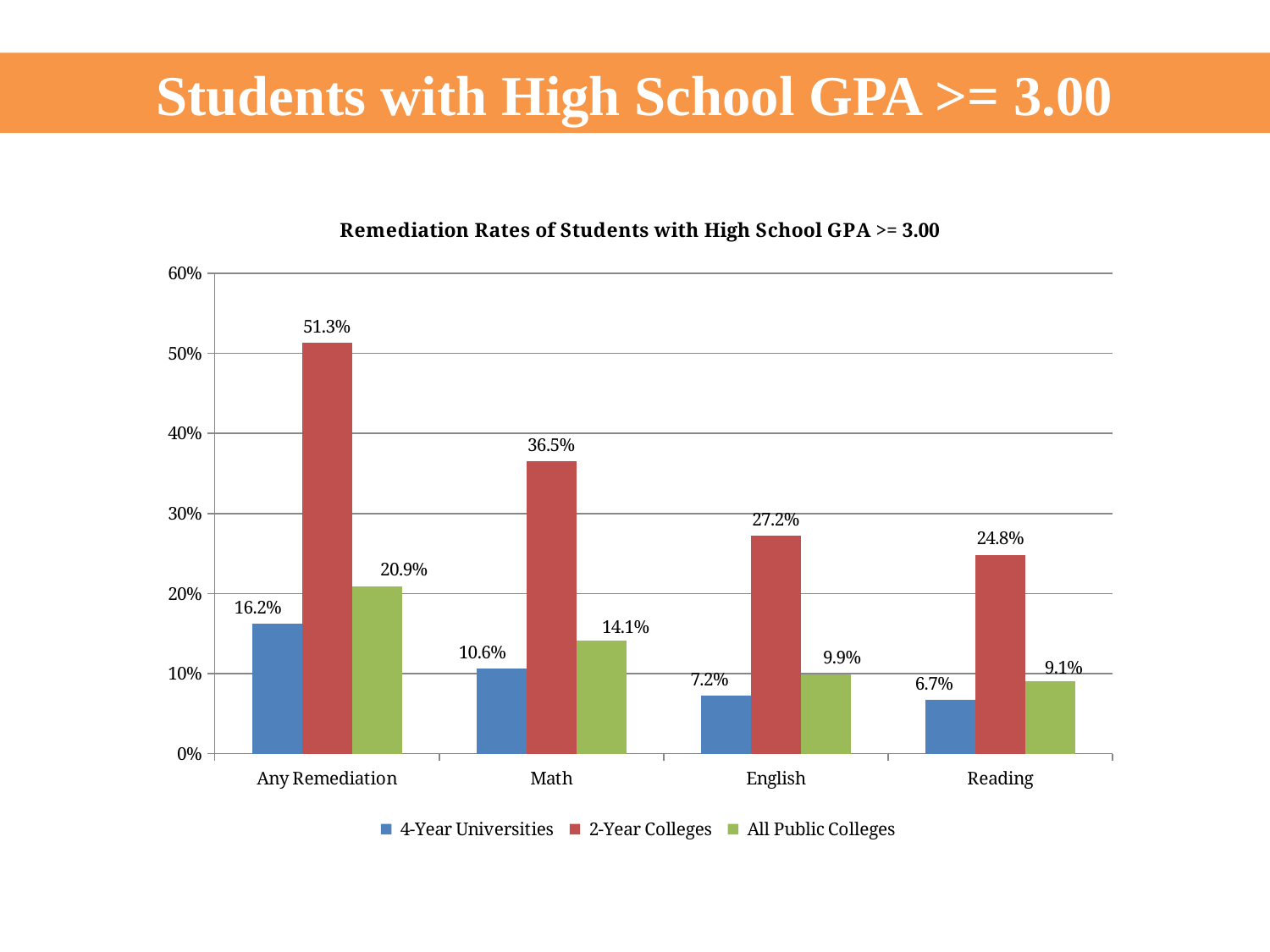
What is the remediation rate for 4-Year Universities in Math? 10.6% What is the remediation rate for All Public Colleges in Reading? 9.1% What kind of chart is shown on the slide? Bar chart Which is larger in Math: the rate for All Public Colleges or for 4-Year Universities? All Public Colleges How many series does the legend list? 3 Which category has the lowest remediation rate for 2-Year Colleges? Reading Which category has the highest remediation rate for 4-Year Universities? Any Remediation What is the title of the chart? Remediation Rates of Students with High School GPA >= 3.00 What is the remediation rate for 2-Year Colleges in the Any Remediation category? 51.3% How many categories are shown on the x axis? 4 What is the difference between the 2-Year Colleges and 4-Year Universities rates in English? 20.0% Is the 2-Year Colleges rate for Any Remediation greater or less than 50%? greater